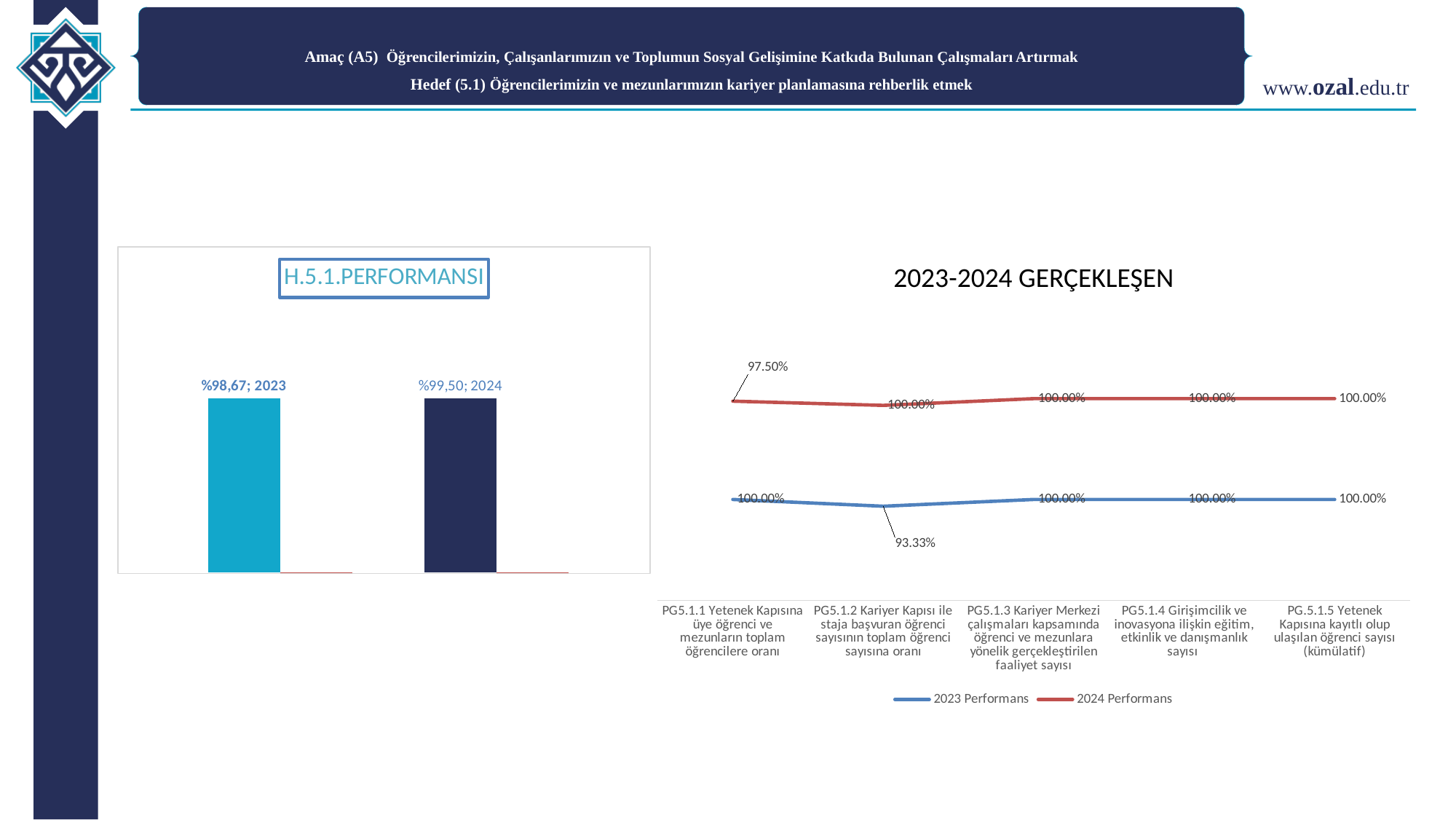
In the H.5.1.PERFORMANSI chart, what is the value for 2024? %99,50 In the 2023-2024 GERÇEKLEŞEN chart, what is the 2023 Performans value for PG.5.1.5 Yetenek Kapısına kayıtlı olup ulaşılan öğrenci sayısı (kümülatif)? 100.00% In the H.5.1.PERFORMANSI chart, which year has the higher value, 2023 or 2024? 2024 In the 2023-2024 GERÇEKLEŞEN chart, what is the 2024 Performans value for PG5.1.1 Yetenek Kapısına üye öğrenci ve mezunların toplam öğrencilere oranı? 97.50% How many categories are shown on the x axis of the 2023-2024 GERÇEKLEŞEN chart? 5 How many series does the legend of the 2023-2024 GERÇEKLEŞEN chart list? 2 In the H.5.1.PERFORMANSI chart, what is the value for 2023? %98,67 In the 2023-2024 GERÇEKLEŞEN chart, which category has the lowest 2024 Performans value? PG5.1.1 Yetenek Kapısına üye öğrenci ve mezunların toplam öğrencilere oranı In the 2023-2024 GERÇEKLEŞEN chart, what is the 2023 Performans value for PG5.1.2 Kariyer Kapısı ile staja başvuran öğrenci sayısının toplam öğrenci sayısına oranı? 93.33% What kind of chart is the H.5.1.PERFORMANSI chart? Bar chart In the 2023-2024 GERÇEKLEŞEN chart, which category has the lowest 2023 Performans value? PG5.1.2 Kariyer Kapısı ile staja başvuran öğrenci sayısının toplam öğrenci sayısına oranı In the 2023-2024 GERÇEKLEŞEN chart, what is the difference between the 2023 Performans and 2024 Performans values for PG5.1.2? 6.67%